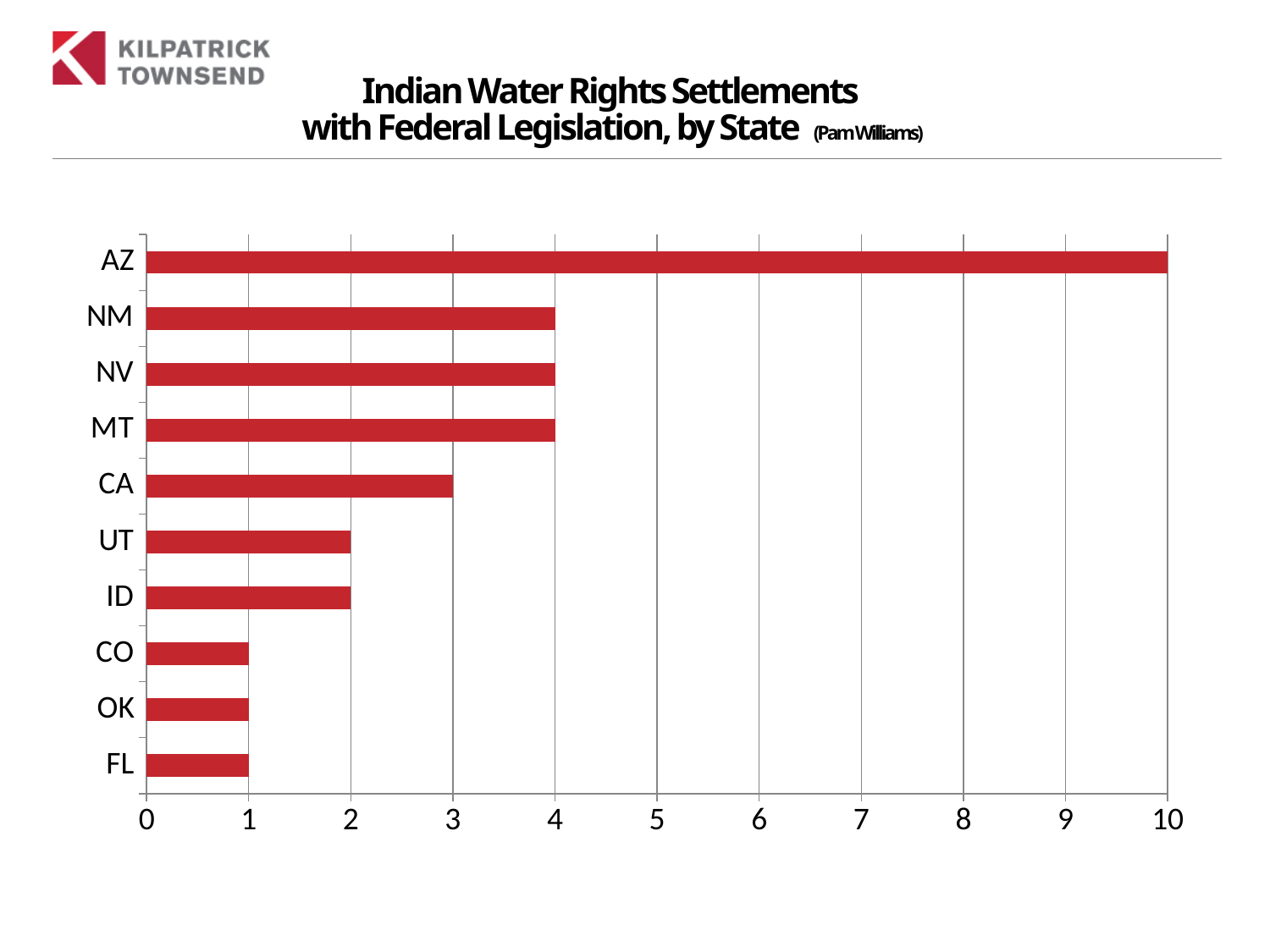
What is the difference between the values for CA and FL? 2 How many states are shown in the chart? 10 What is the value for UT? 2 What is the value for CA? 3 What is the value for AZ? 10 Which state has the highest value? AZ What is the title of the chart? Indian Water Rights Settlements with Federal Legislation, by State Is the value for AZ greater or less than 5? greater What kind of chart is shown on the slide? bar chart What is the value for NM? 4 What is the difference between the values for AZ and MT? 6 Which is larger, the value for NV or the value for ID? NV